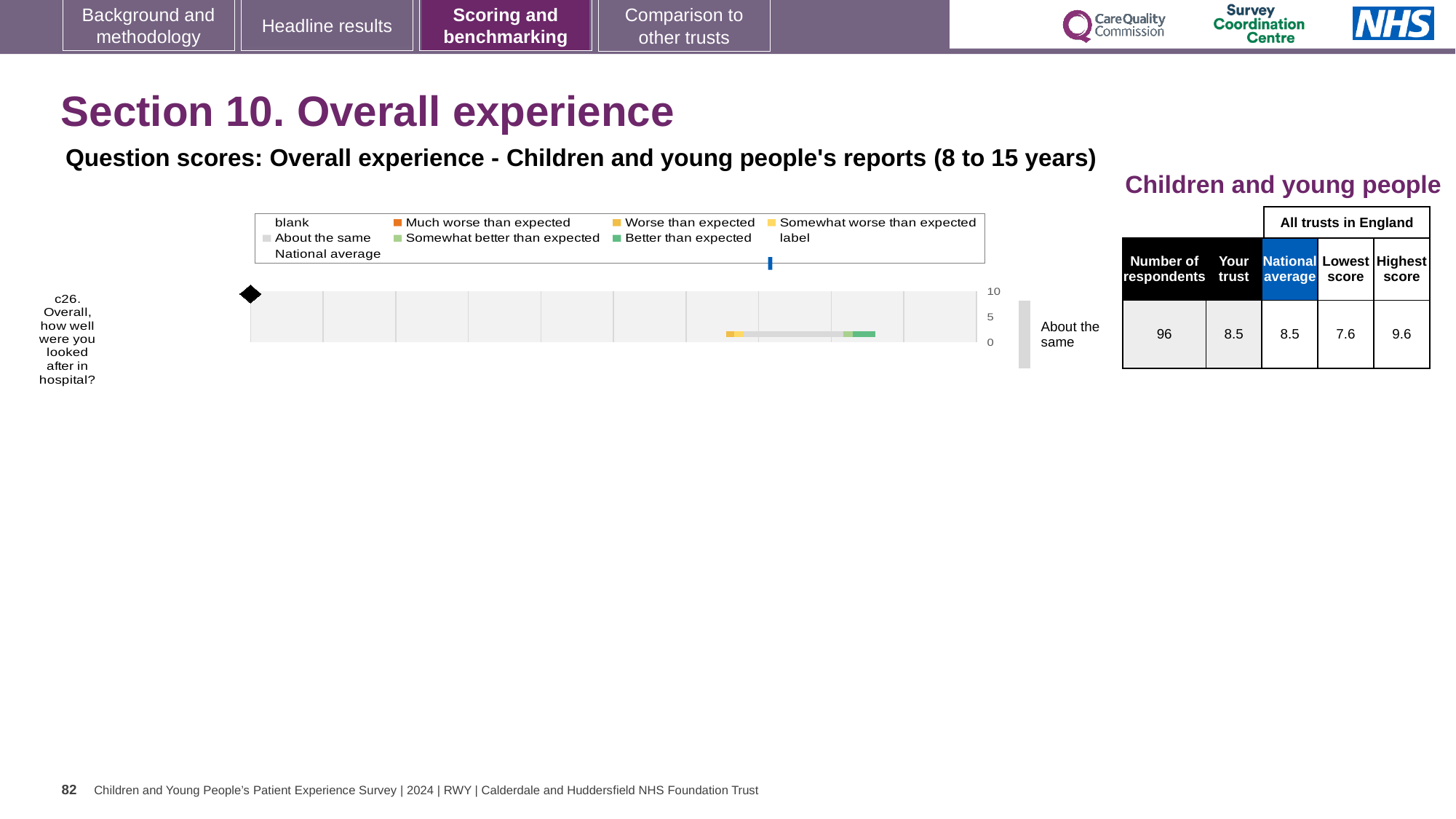
What is the maximum value shown on the chart's score axis? 10 Which question is plotted in the chart? c26. Overall, how well were you looked after in hospital? How many questions (categories) are plotted in the chart? 1 What is the lowest score among all trusts in England for question c26? 7.6 How many respondents answered question c26? 96 What is the difference between the highest score and the lowest score for question c26? 2.0 What is the highest score among all trusts in England for question c26? 9.6 What is the national average score for question c26? 8.5 What is the 'Your trust' score for question c26? 8.5 What benchmark category is shown next to the chart for question c26? About the same What kind of chart is shown on the slide? bar chart Which is larger for question c26: the highest score or the 'Your trust' score? Highest score